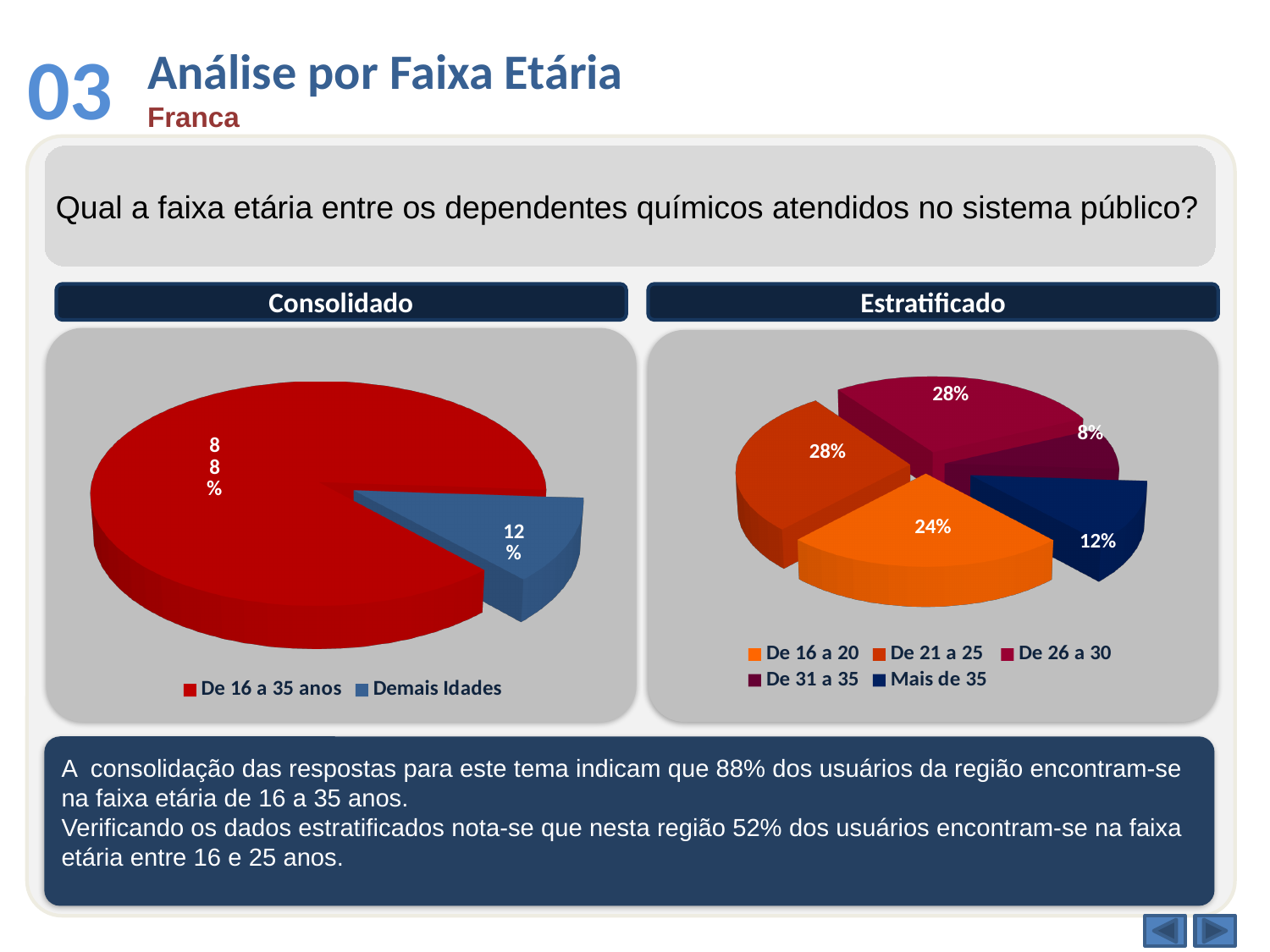
In the Consolidado chart, what percentage is shown for Demais Idades? 12% In the Estratificado chart, which category has the smallest share? De 31 a 35 In the Estratificado chart, what percentage is shown for De 31 a 35? 8% In the Consolidado chart, what percentage is shown for De 16 a 35 anos? 88% In the Estratificado chart, which is larger: De 16 a 20 or Mais de 35? De 16 a 20 In the Estratificado chart, what percentage is shown for De 16 a 20? 24% How many categories does the legend of the Estratificado chart list? 5 In the Estratificado chart, what percentage is shown for Mais de 35? 12% In the Consolidado chart, which category has the largest share? De 16 a 35 anos In the Estratificado chart, what is the combined share of De 16 a 20 and De 21 a 25? 52% In the Consolidado chart, what is the difference between the De 16 a 35 anos share and the Demais Idades share? 76% What kind of chart is the Consolidado chart? Pie chart